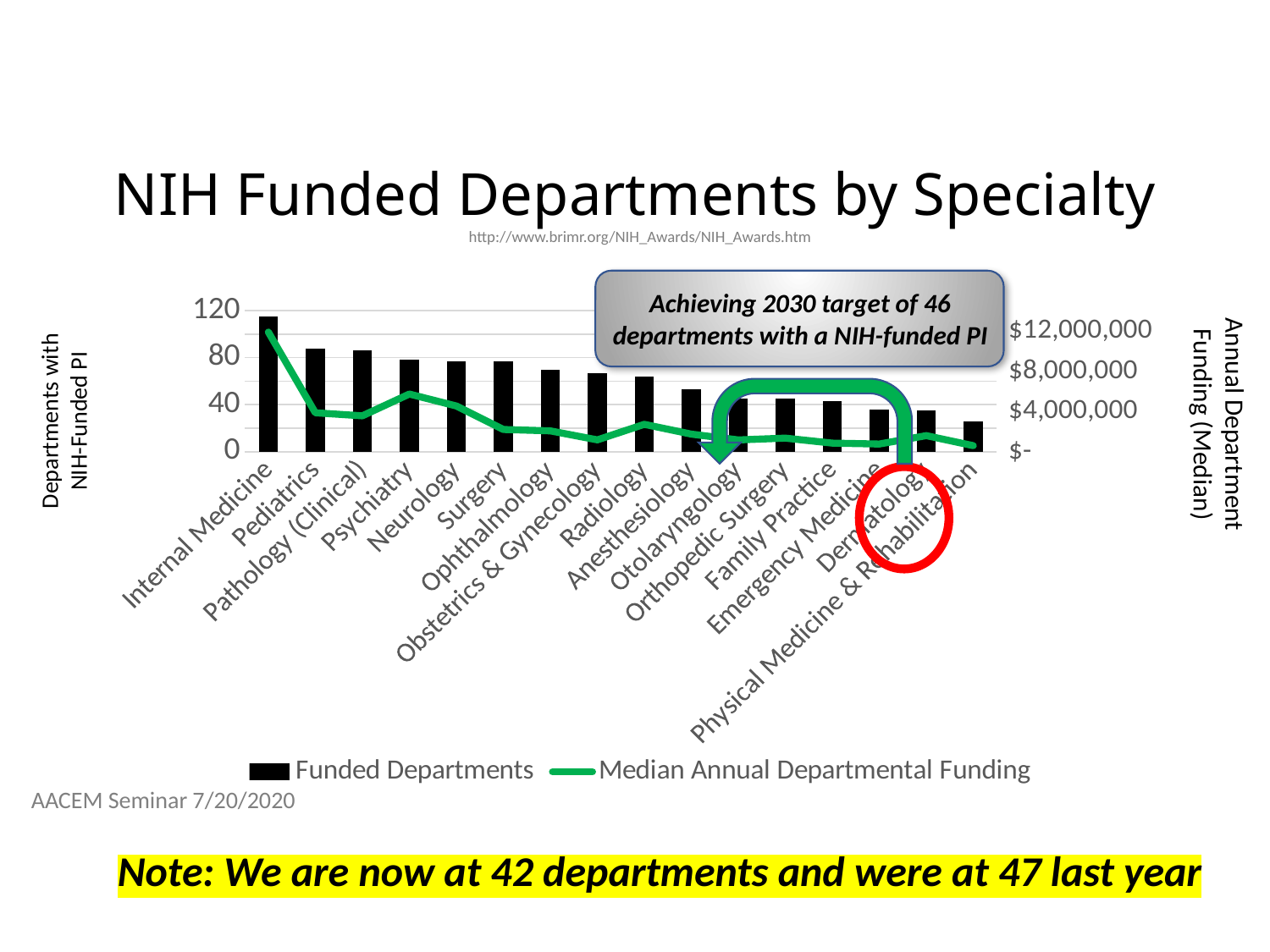
Which specialty has the lowest number of funded departments? Physical Medicine & Rehabilitation Which specialty has the highest number of funded departments? Internal Medicine Which has more funded departments, Internal Medicine or Pediatrics? Internal Medicine What are the two series named in the legend? Funded Departments and Median Annual Departmental Funding Is the number of funded departments for Physical Medicine & Rehabilitation greater or less than 40? less Do the Funded Departments bars generally rise or fall from left to right along the x axis? fall What kind of chart is shown on the slide? A combined bar and line chart How many series does the legend list? 2 How many specialties are shown on the x axis? 16 Which specialty has the highest median annual departmental funding? Internal Medicine Is the median annual departmental funding for Internal Medicine greater or less than $8,000,000? greater Is the number of funded departments for Internal Medicine greater or less than 80? greater